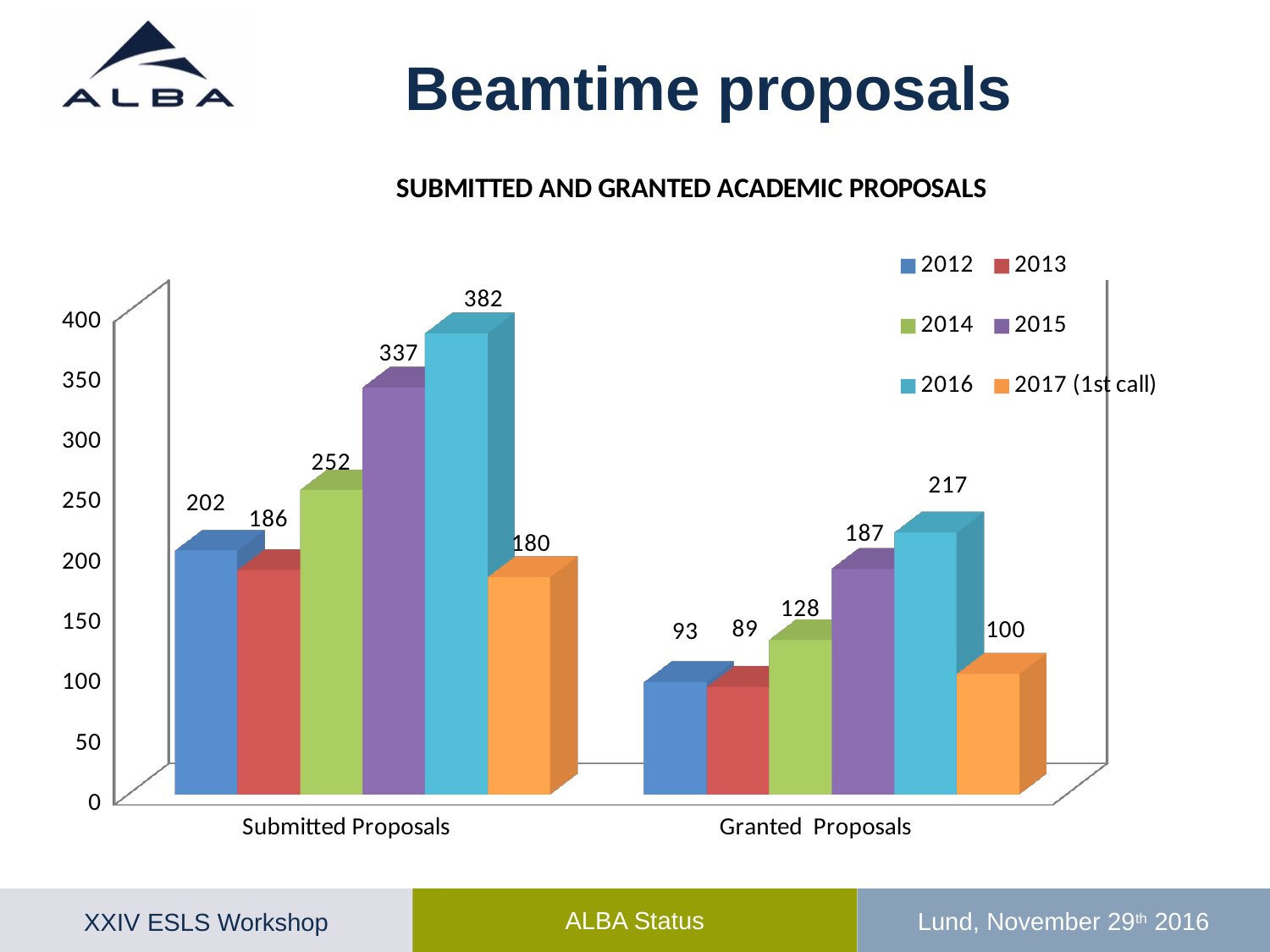
Which is larger: Granted Proposals for 2012 or for 2013? 2012 How many series does the legend list? 6 What is the difference between Submitted Proposals and Granted Proposals for 2015? 150 Which year has the highest number of Submitted Proposals? 2016 What is the number of Granted Proposals for 2014? 128 What is the difference between Submitted Proposals in 2016 and 2015? 45 How many categories are shown on the x axis? 2 What kind of chart is shown on the slide? Bar chart What is the number of Submitted Proposals for 2016? 382 What is the number of Submitted Proposals for 2017 (1st call)? 180 What is the title of the chart? SUBMITTED AND GRANTED ACADEMIC PROPOSALS Which year has the lowest number of Granted Proposals? 2013